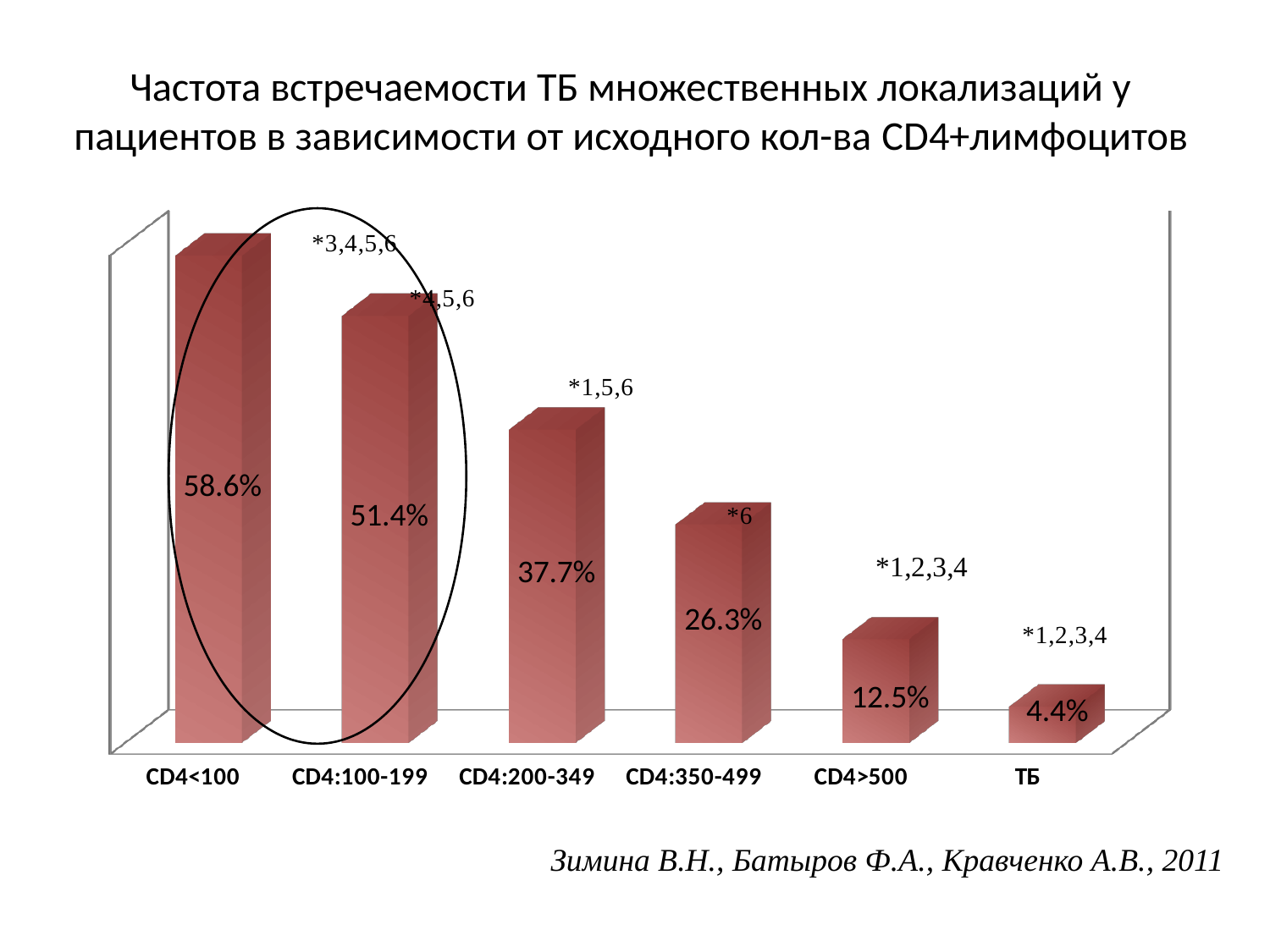
What is the value for CD4:100-199? 51.4% How many categories are shown on the x axis? 6 What is the value for CD4:200-349? 37.7% What is the difference between the values for CD4<100 and CD4:100-199? 7.2% What is the difference between the values for CD4:350-499 and CD4>500? 13.8% What is the value for CD4<100? 58.6% Which is larger, the value for CD4:200-349 or the value for CD4:350-499? CD4:200-349 Which category has the lowest value? ТБ Do the values rise or fall from left to right along the x axis? fall What is the value for CD4>500? 12.5% What kind of chart is shown on the slide? bar chart Which category has the highest value? CD4<100